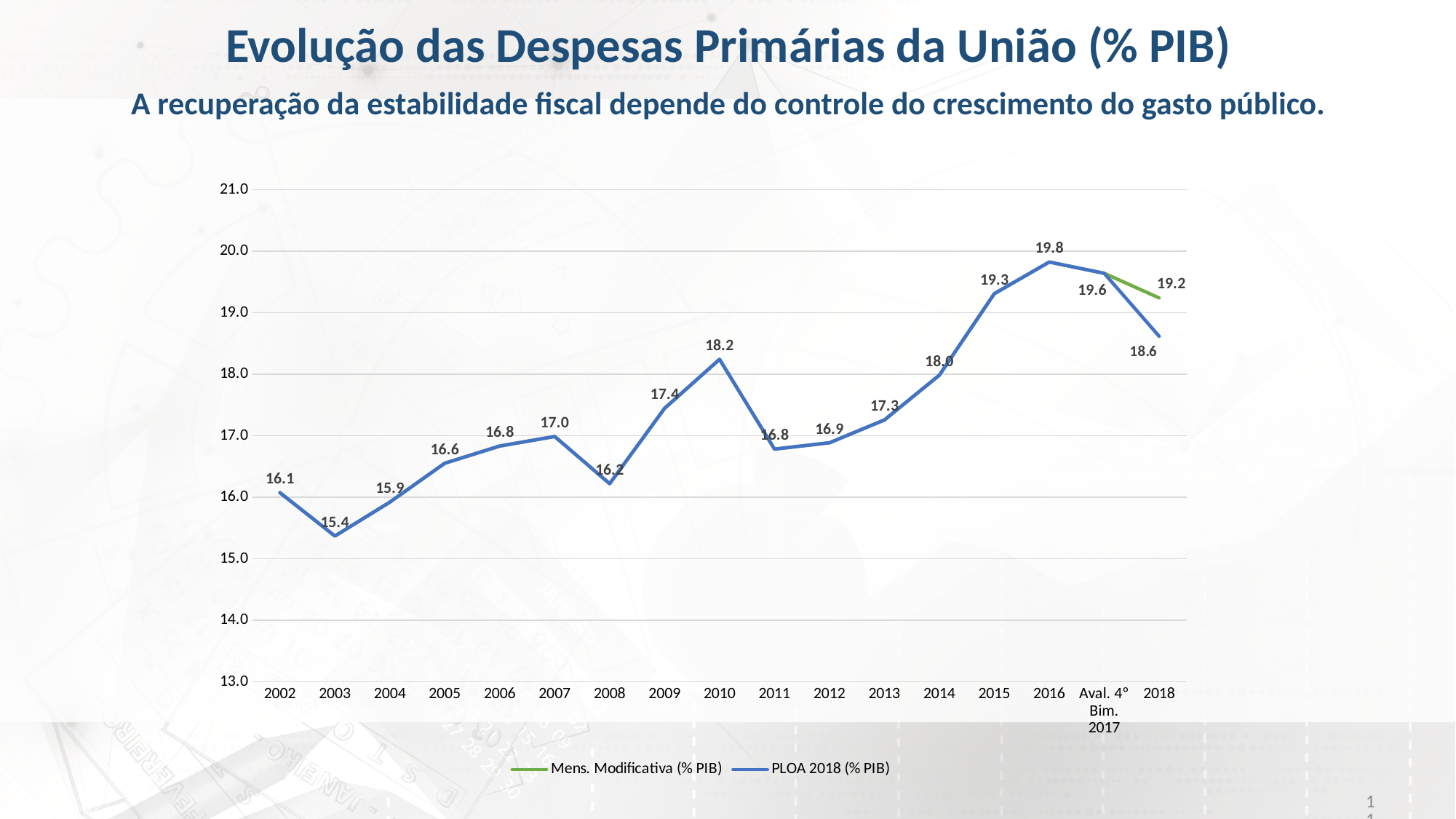
Which is larger, the PLOA 2018 (% PIB) value for 2010 or for 2014? 2010 Does the PLOA 2018 (% PIB) line rise or fall from 2011 to 2016? rise Which year has the lowest PLOA 2018 (% PIB) value? 2003 How many categories are shown on the x axis? 17 What is the difference between the PLOA 2018 (% PIB) value for 2016 and the value for 2018? 1.2 What is the title of the chart on the slide? Evolução das Despesas Primárias da União (% PIB) What is the PLOA 2018 (% PIB) value for 2003? 15.4 Which year has the highest PLOA 2018 (% PIB) value? 2016 What is the Mens. Modificativa (% PIB) value for 2018? 19.2 What is the PLOA 2018 (% PIB) value for 2010? 18.2 How many series does the legend list? 2 What type of chart is shown on the slide? line chart